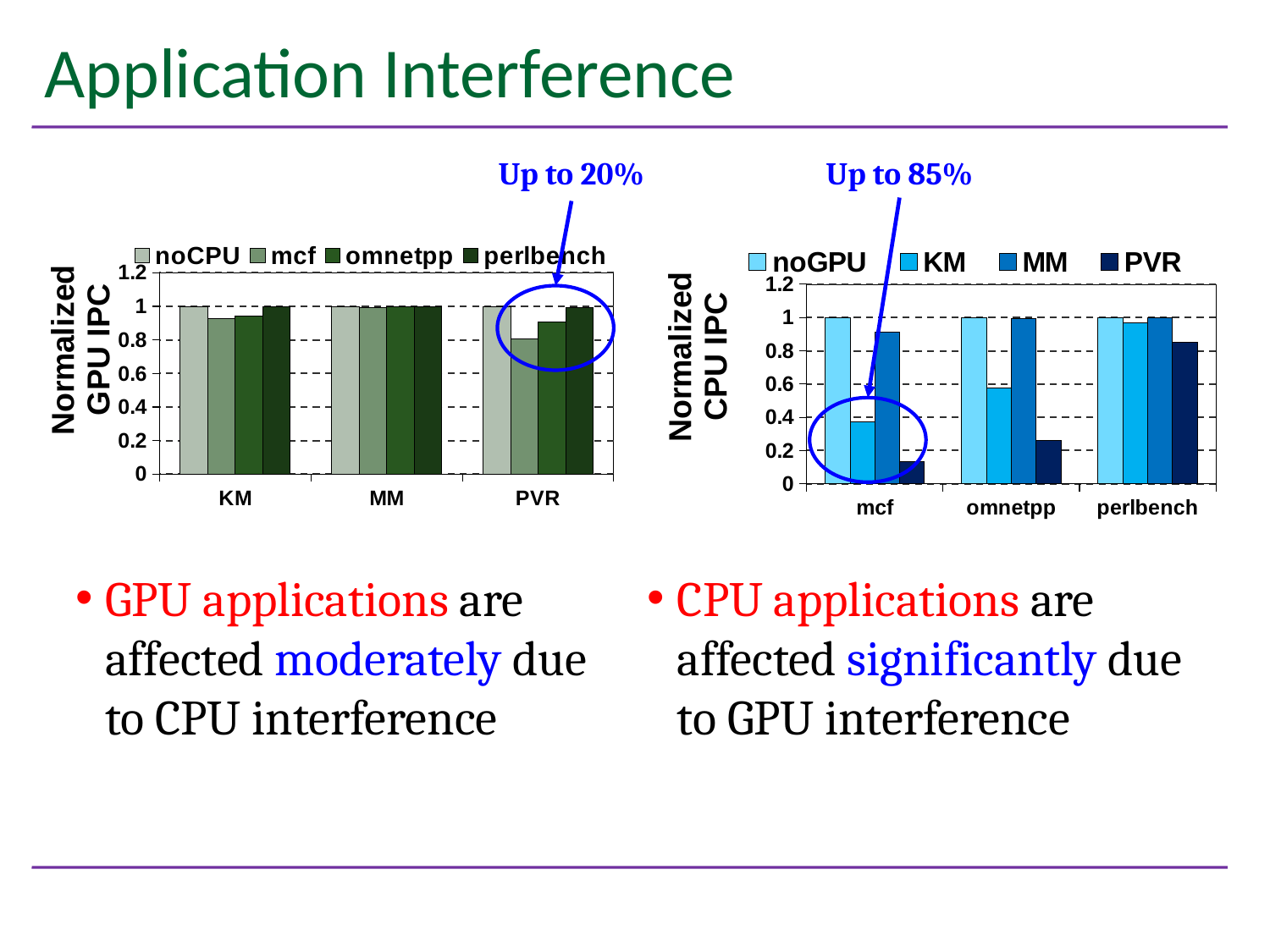
In the left chart (Normalized GPU IPC), which series has the lowest value for PVR? mcf In the right chart (Normalized CPU IPC), is the KM value for mcf greater or less than 0.6? less What is the y-axis title of the left chart? Normalized GPU IPC How many categories are shown on the x axis of the right chart (Normalized CPU IPC)? 3 How many series does the legend of the left chart (Normalized GPU IPC) list? 4 In the right chart (Normalized CPU IPC), for mcf, which is larger: KM or MM? MM What kind of chart is the left chart (Normalized GPU IPC)? bar chart How many categories are shown on the x axis of the left chart (Normalized GPU IPC)? 3 In the left chart (Normalized GPU IPC), what is the noCPU value for KM? 1 How many series does the legend of the right chart (Normalized CPU IPC) list? 4 In the right chart (Normalized CPU IPC), is the PVR value for omnetpp greater or less than 0.4? less In the right chart (Normalized CPU IPC), which series has the lowest value for mcf? PVR